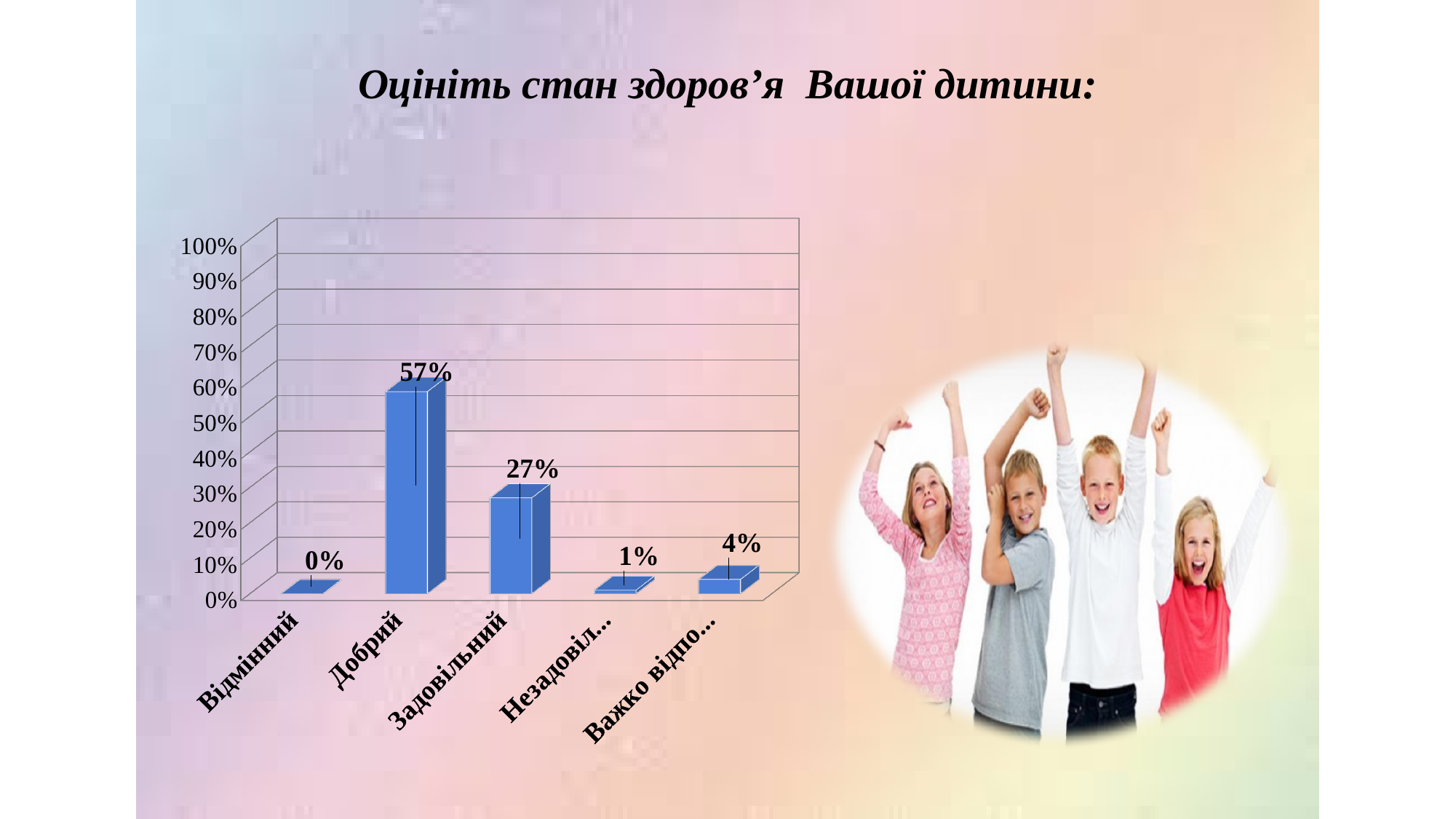
What is the title of the slide above the chart? Оцініть стан здоров’я Вашої дитини: What is the value for the fourth category (labelled Незадовіл...)? 1% Which is larger, the value for Задовільний or the value for the last category (Важко відпо...)? Задовільний What kind of chart is shown on the slide? Bar chart What is the difference between the values for Добрий and Задовільний? 30% What is the value for Добрий? 57% What is the value for Задовільний? 27% What is the value for Відмінний? 0% Which category has the highest value? Добрий Which category has the lowest value? Відмінний What is the value for the last category (labelled Важко відпо...)? 4% How many categories are shown on the chart? 5